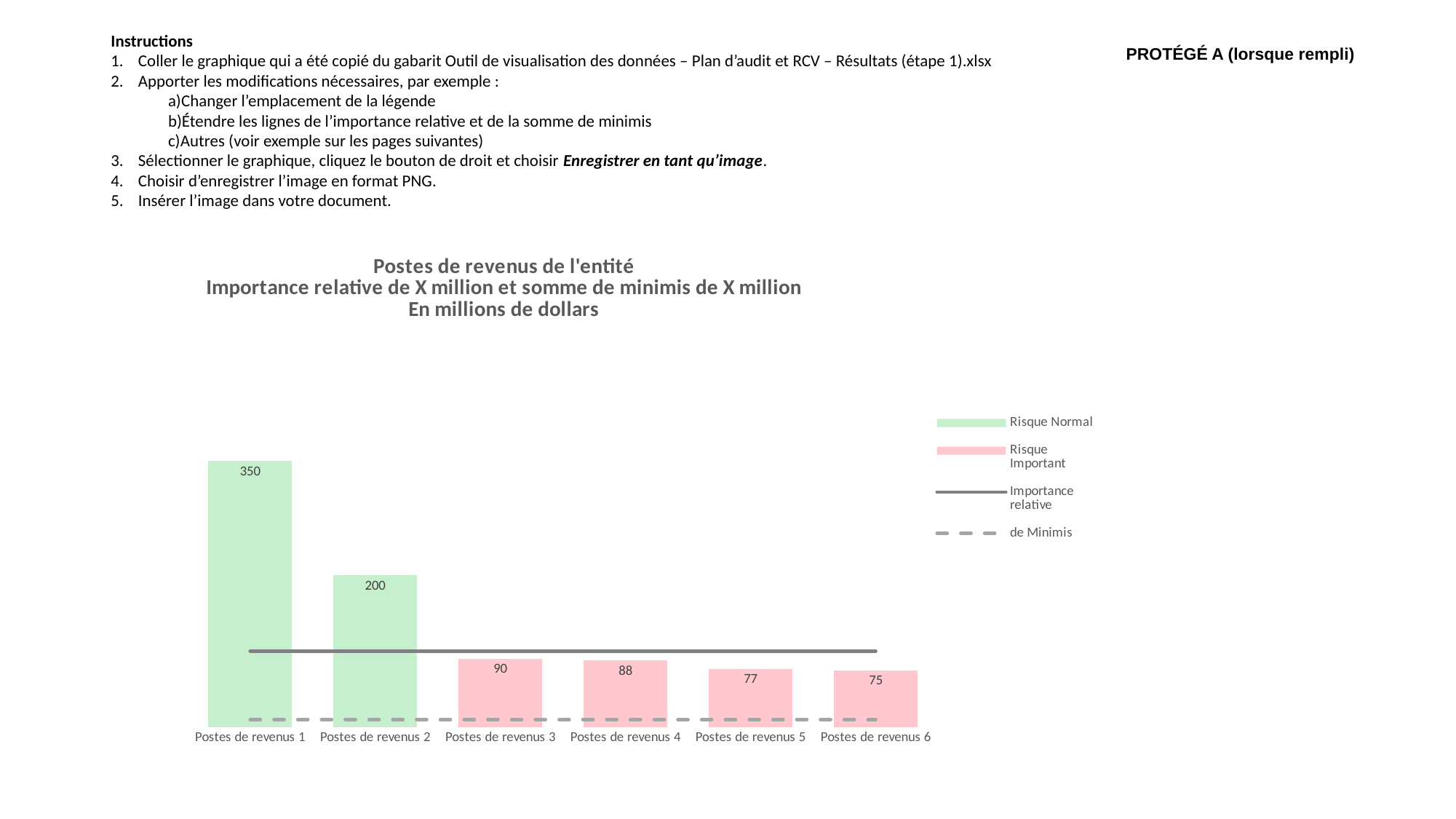
Which category has the lowest value? Postes de revenus 6 How many categories are shown on the x axis? 6 What is the difference between the values for Postes de revenus 1 and Postes de revenus 2? 150 Do the bar values rise or fall from left to right along the x axis? fall What is the value for Postes de revenus 6? 75 How many entries does the legend list? 4 What is the difference between the values for Postes de revenus 4 and Postes de revenus 5? 11 Which is larger, the value for Postes de revenus 2 or Postes de revenus 3? Postes de revenus 2 What is the value for Postes de revenus 3? 90 Which category has the highest value? Postes de revenus 1 What kind of chart is shown? combination bar and line chart What is the value for Postes de revenus 1? 350